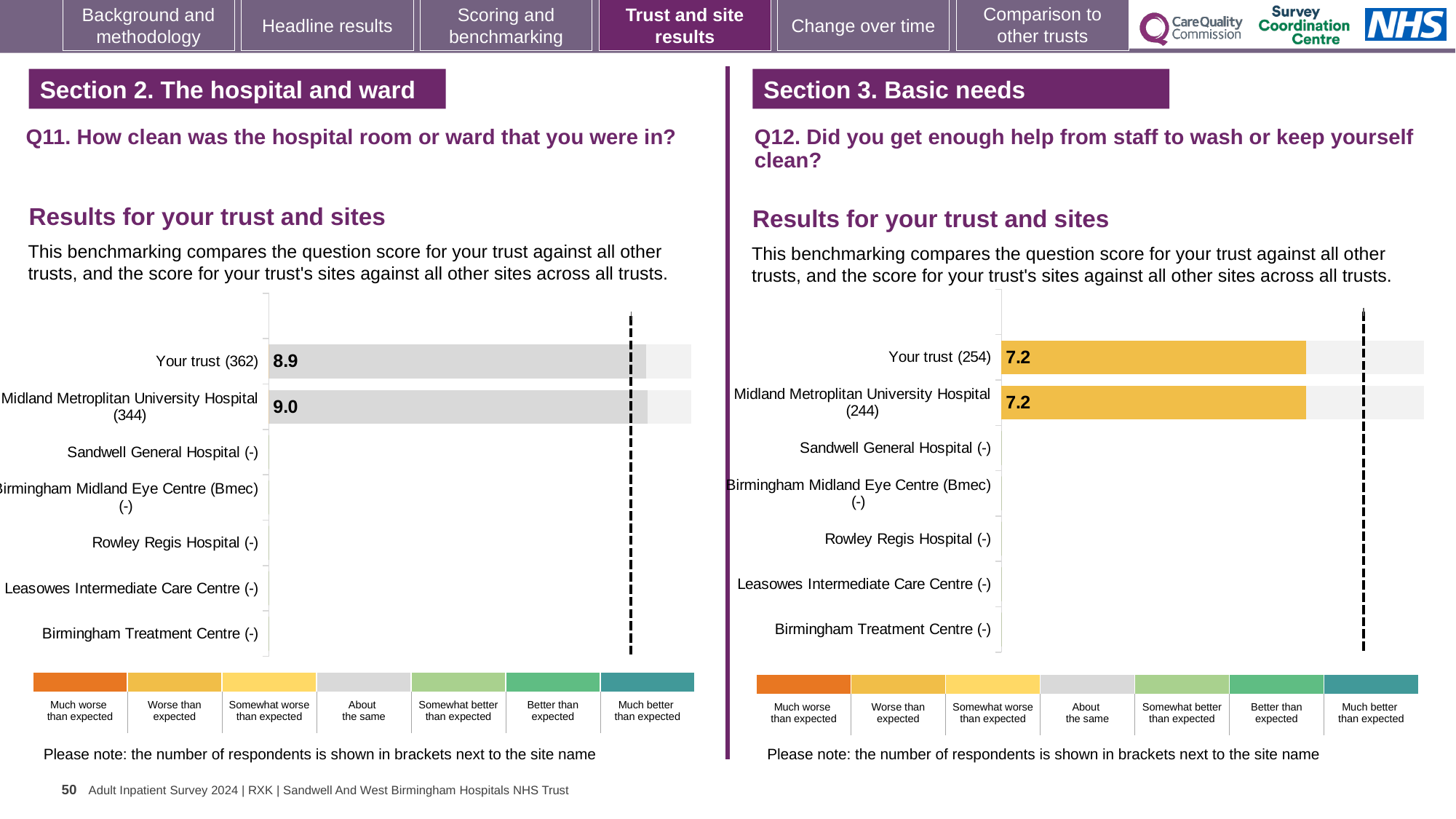
In the Q12 chart on the right, how many respondents are shown in brackets for Midland Metropolitan University Hospital? 244 In the Q12 chart on the right, what is the score for Midland Metropolitan University Hospital? 7.2 What type of chart is used for the Q11 results on the left? Bar chart In the Q11 chart on the left, what is the difference between the Midland Metropolitan University Hospital score and the Your trust score? 0.1 In the Q12 chart on the right, what is the score for Your trust? 7.2 In the Q12 chart on the right, what is the difference between the Your trust score and the Midland Metropolitan University Hospital score? 0 How many site/trust categories are listed on the y axis of the Q12 chart on the right? 7 In the Q11 chart on the left, which has the higher score: Your trust or Midland Metropolitan University Hospital? Midland Metropolitan University Hospital In the Q11 chart on the left, what is the score for Midland Metropolitan University Hospital? 9.0 How many site/trust categories are listed on the y axis of the Q11 chart on the left? 7 In the Q11 chart on the left, how many respondents are shown in brackets for Your trust? 362 In the Q11 chart on the left, what is the score for Your trust? 8.9